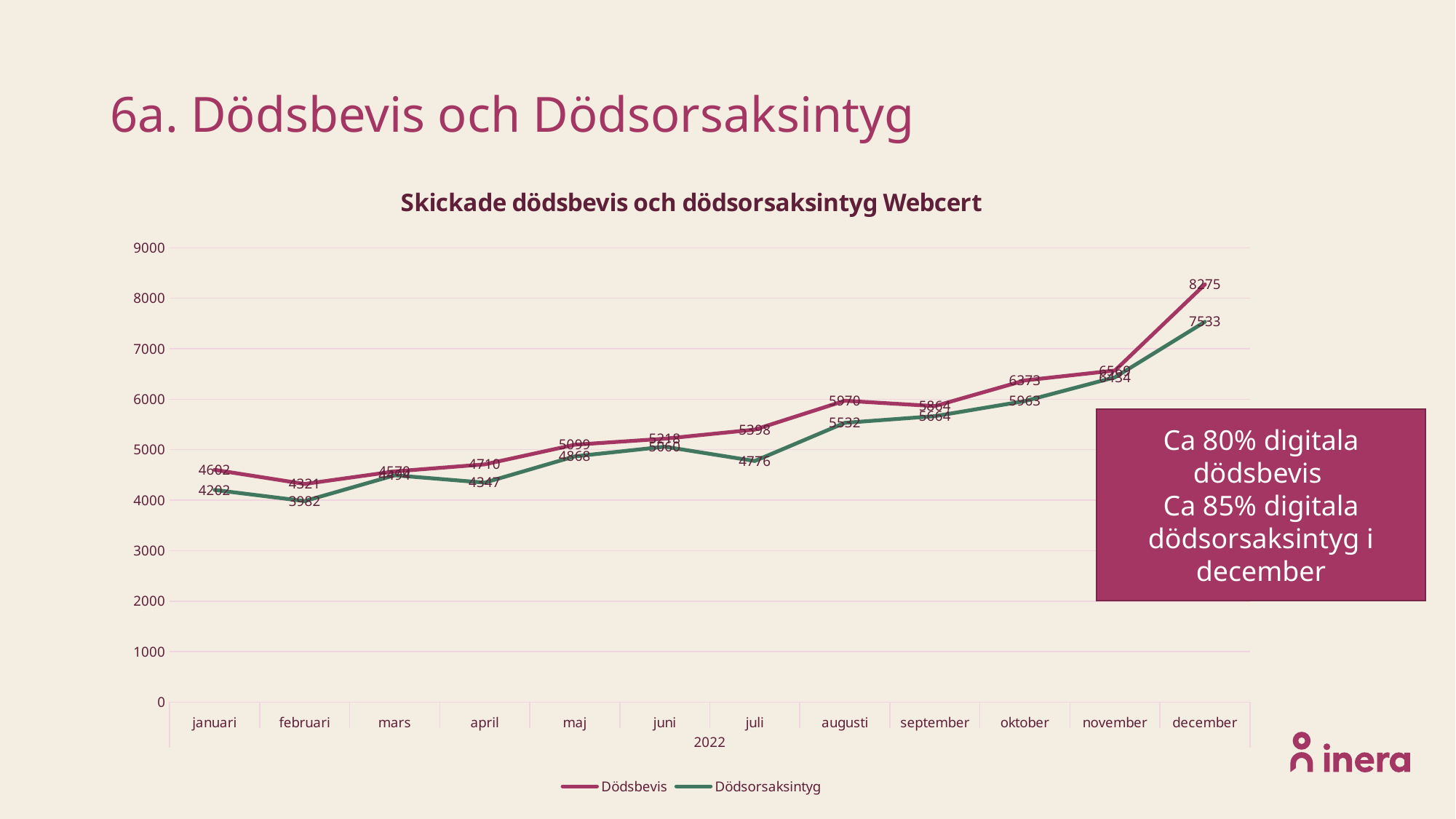
In which month is the Dödsbevis value highest? december In which month is the Dödsorsaksintyg value lowest? februari Do the Dödsbevis values generally rise or fall from januari to december? rise Is the value for Dödsorsaksintyg in juli greater or less than 5000? less How many months are plotted along the x axis? 12 What kind of chart is shown on the slide? line chart What is the value for Dödsbevis in december? 8275 What is the difference between Dödsbevis and Dödsorsaksintyg in december? 742 What is the value for Dödsorsaksintyg in augusti? 5532 What is the value for Dödsorsaksintyg in februari? 3982 Which series has the larger value in juli, Dödsbevis or Dödsorsaksintyg? Dödsbevis How many series does the legend list? 2